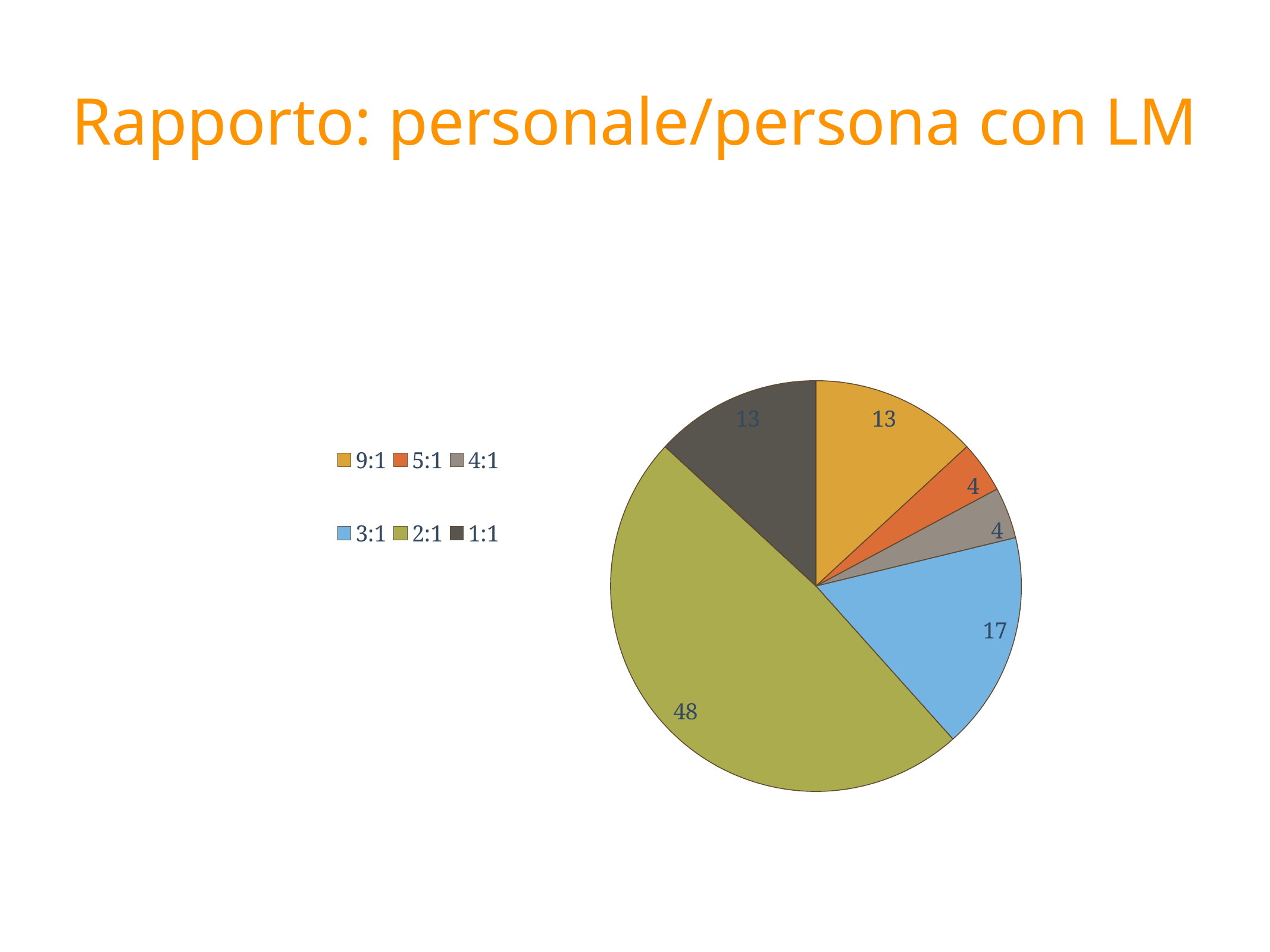
What is the value of the 3:1 slice? 17 What is the value of the 9:1 slice? 13 What is the value of the 1:1 slice? 13 What is the value of the 5:1 slice? 4 What is the title of the slide containing the pie chart? Rapporto: personale/persona con LM Which is larger, the 3:1 slice or the 9:1 slice? 3:1 What is the difference between the values of the 2:1 and 3:1 slices? 31 How many categories does the pie chart have? 6 Which category has the largest slice of the pie? 2:1 What type of chart is shown on the slide? pie chart What is the value of the 2:1 slice? 48 What is the difference between the values of the 3:1 and 1:1 slices? 4